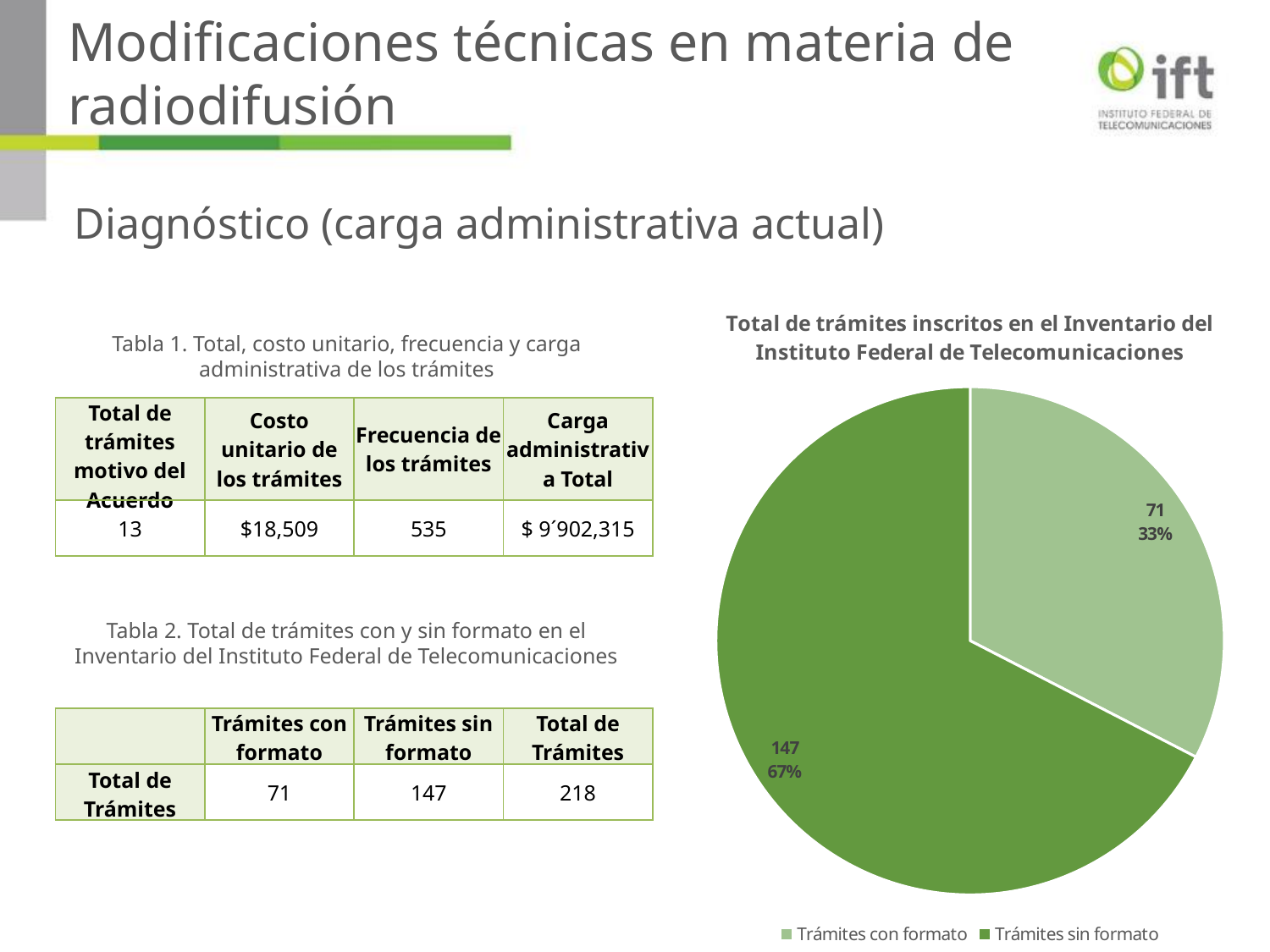
What is the title of the pie chart? Total de trámites inscritos en el Inventario del Instituto Federal de Telecomunicaciones Which slice of the pie chart is the largest? Trámites sin formato What kind of chart is shown on the slide? Pie chart What is the difference between the values for Trámites sin formato and Trámites con formato in the pie chart? 76 Which slice of the pie chart is the smallest? Trámites con formato What is the value for Trámites con formato in the pie chart? 71 What is the value for Trámites sin formato in the pie chart? 147 Which is larger in the pie chart, Trámites con formato or Trámites sin formato? Trámites sin formato What share of the pie does Trámites con formato represent? 33% What share of the pie does Trámites sin formato represent? 67% How many entries does the pie chart's legend list? 2 How many slices does the pie chart have? 2